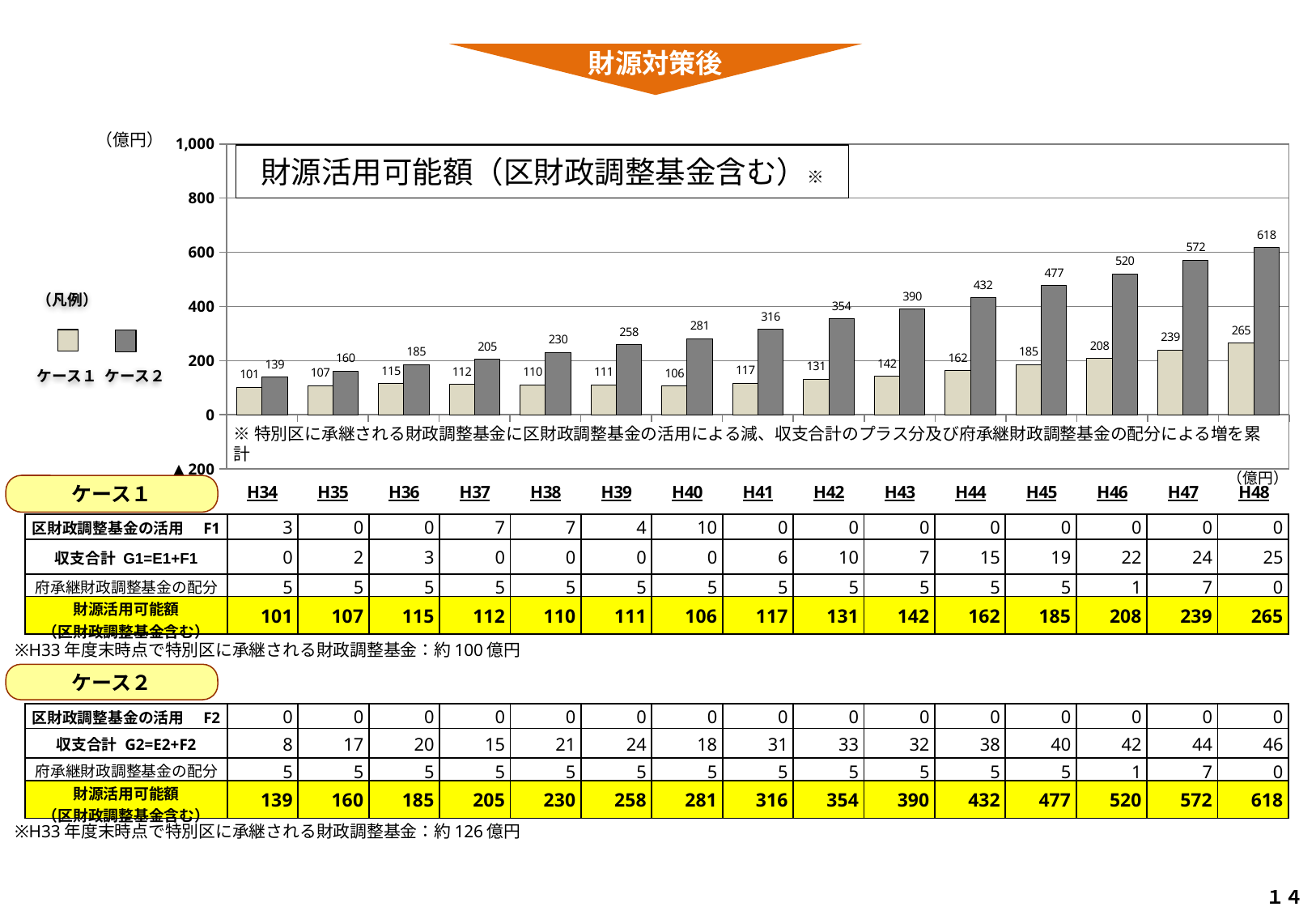
What is the value for ケース2 in H48? 618 What is the title of the chart? 財源活用可能額（区財政調整基金含む） What is the value for ケース2 in H41? 316 Do the ケース2 values rise or fall from H34 to H48? rise What is the value for ケース1 in H40? 106 How many year categories are plotted along the x axis of the chart? 15 In which year is the ケース1 value lowest? H34 What type of chart is shown on the slide? bar chart Which is larger in H44: the ケース1 value or the ケース2 value? ケース2 In which year is the ケース2 value highest? H48 How many series does the chart legend list? 2 What is the difference between ケース2 and ケース1 in H48? 353